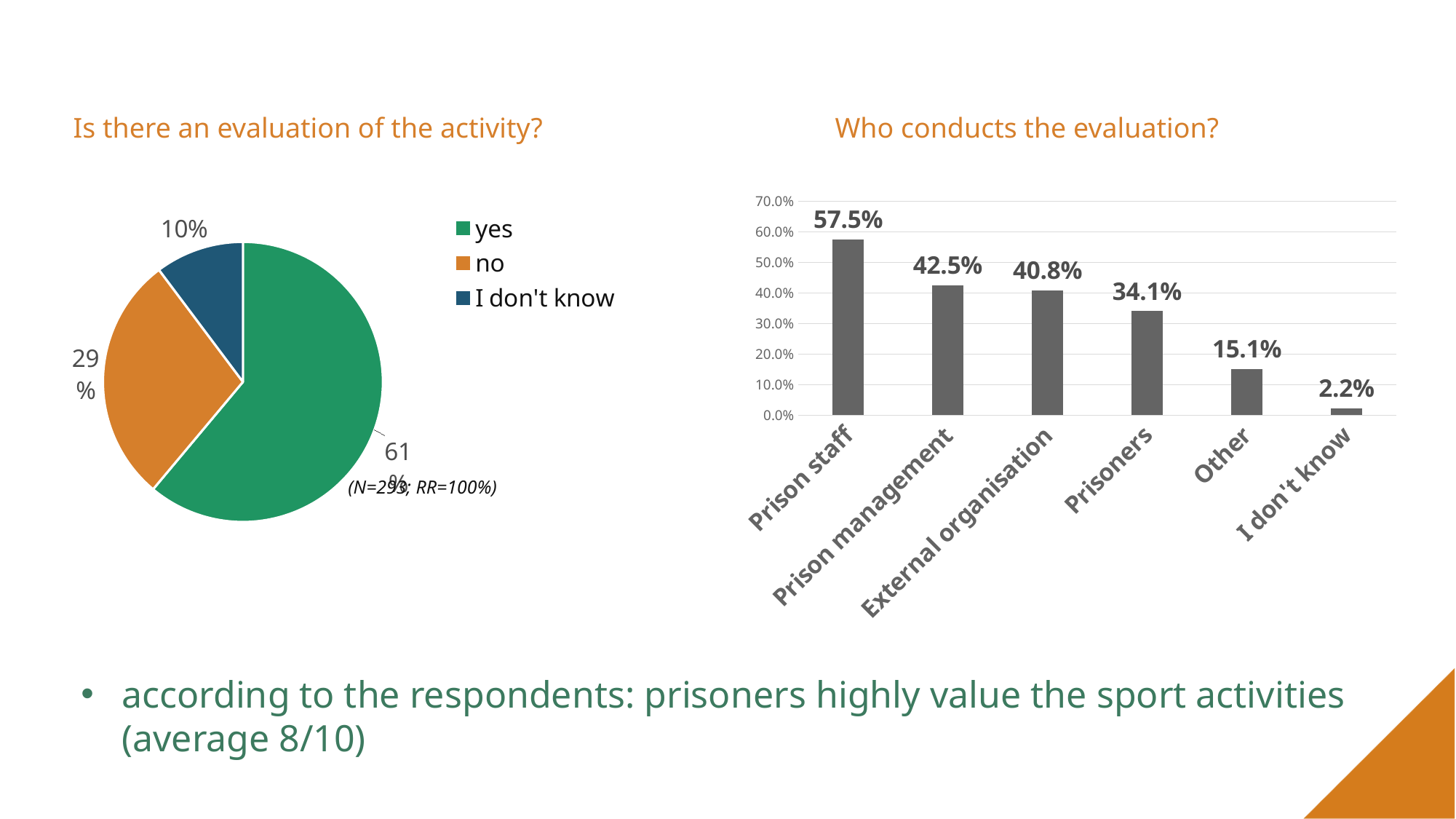
In the 'Is there an evaluation of the activity?' chart, what share of the pie is 'I don't know'? 10% In the 'Who conducts the evaluation?' chart, what is the value for Other? 15.1% In the 'Who conducts the evaluation?' chart, what is the difference between Prison staff and Prisoners? 23.4% In the 'Who conducts the evaluation?' chart, which category has the lowest value? I don't know In the 'Who conducts the evaluation?' chart, which category has the highest value? Prison staff In the 'Who conducts the evaluation?' chart, what is the value for Prison staff? 57.5% What kind of chart is 'Who conducts the evaluation?'? bar chart How many categories are shown in the 'Who conducts the evaluation?' chart? 6 In the 'Who conducts the evaluation?' chart, which is larger: Prison management or Prisoners? Prison management How many entries does the legend of the 'Is there an evaluation of the activity?' chart list? 3 In the 'Who conducts the evaluation?' chart, what is the value for External organisation? 40.8% In the 'Is there an evaluation of the activity?' chart, what share of the pie is 'no'? 29%